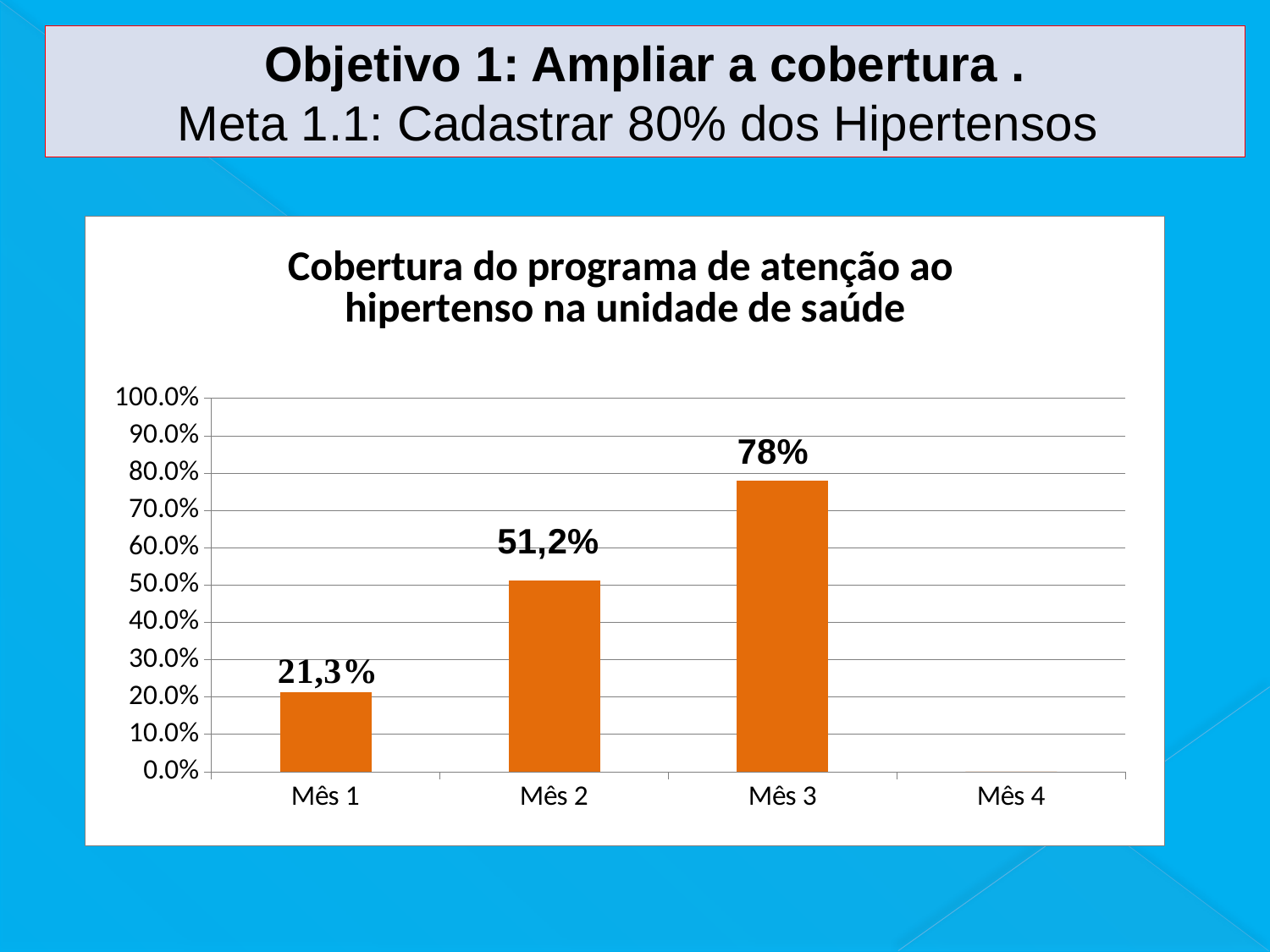
What is the value for Mês 3? 78% What kind of chart is shown on the slide? Bar chart Is the value for Mês 3 greater or less than 70.0%? greater What is the value for Mês 2? 51,2% What is the value for Mês 1? 21,3% How many categories are shown on the x axis? 4 What is the difference between the values for Mês 2 and Mês 1? 29,9% Do the values rise or fall from Mês 1 to Mês 3? Rise What is the difference between the values for Mês 3 and Mês 2? 26,8% Which month with a plotted bar has the lowest coverage value? Mês 1 Which is larger, the value for Mês 2 or the value for Mês 1? Mês 2 Which month has the highest coverage value? Mês 3